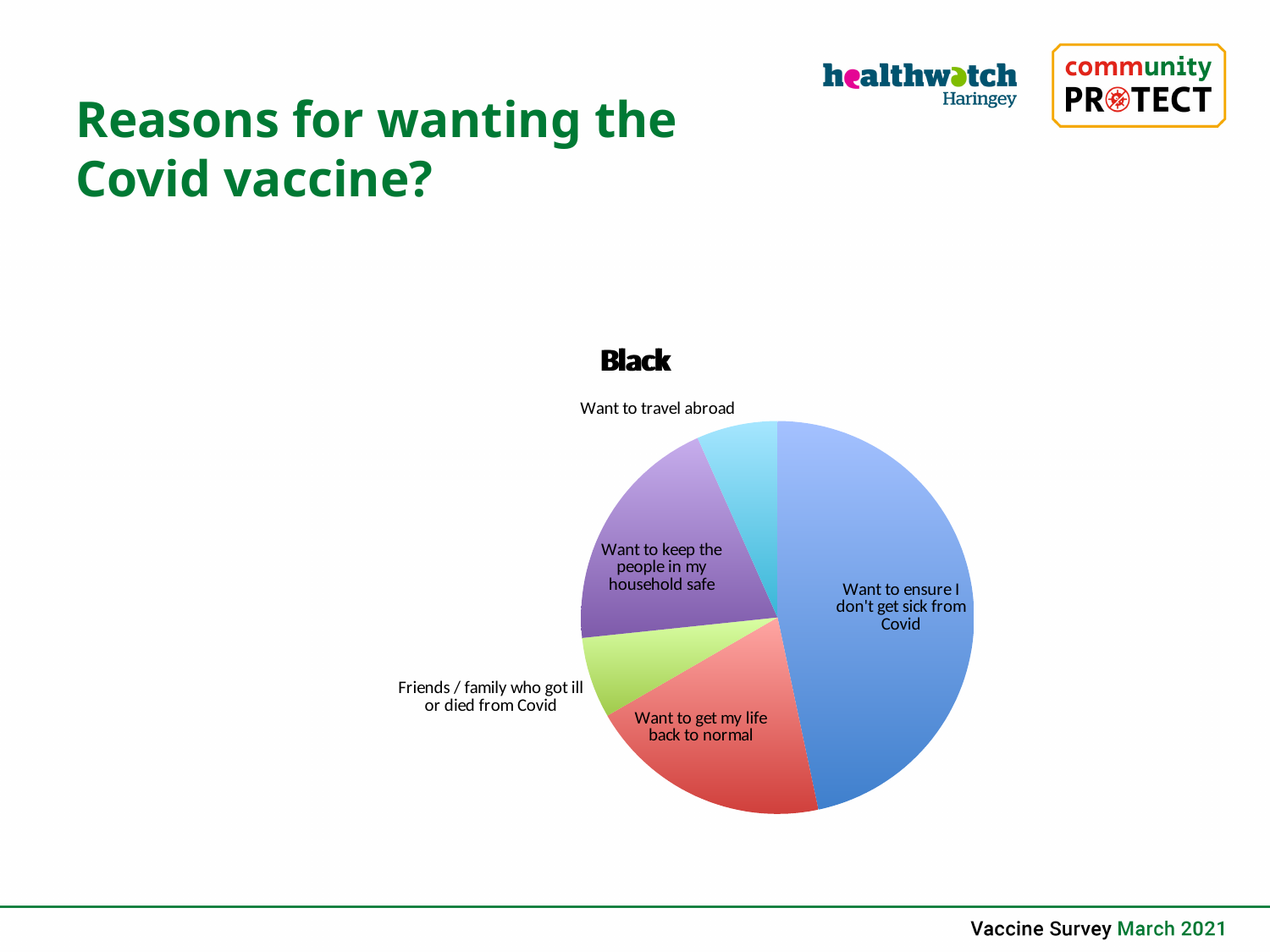
What kind of chart is shown on the slide? pie chart Which reason has the largest slice of the pie chart? Want to ensure I don't get sick from Covid Which slice is larger: "Want to get my life back to normal" or "Friends / family who got ill or died from Covid"? Want to get my life back to normal What is the title of the pie chart? Black What colour is the slice for "Want to travel abroad"? light blue Which slice is larger: "Want to ensure I don't get sick from Covid" or "Want to keep the people in my household safe"? Want to ensure I don't get sick from Covid Which slice is larger: "Want to keep the people in my household safe" or "Want to travel abroad"? Want to keep the people in my household safe How many slices does the pie chart have? 5